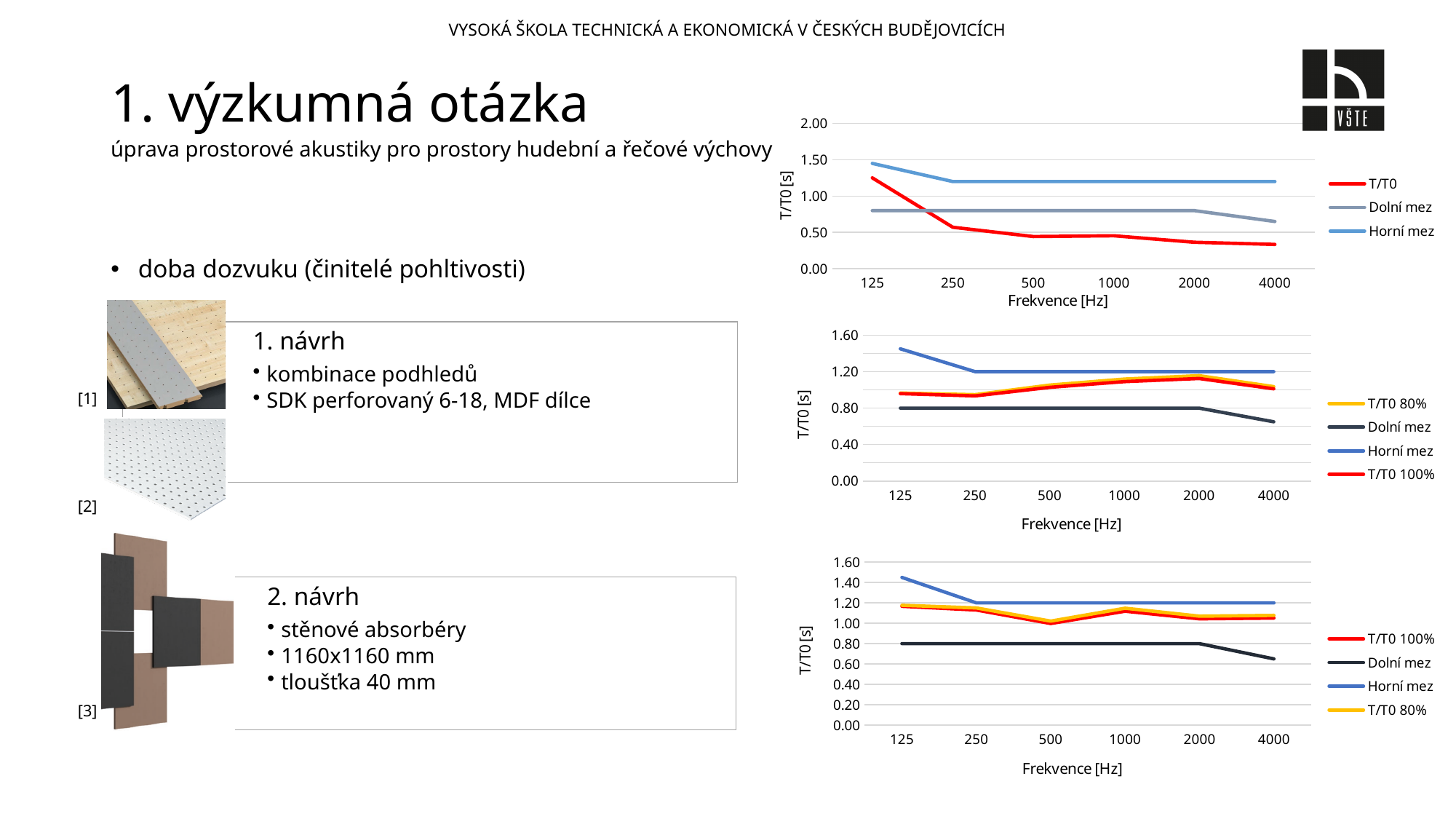
In the bottom chart, what is the value of Horní mez at 2000 Hz? 1.20 How many series does the legend of the top chart list? 3 How many series does the legend of the middle chart list? 4 What is the x-axis label of the middle chart? Frekvence [Hz] What kind of chart is the top chart on the right of the slide? line chart How many frequency points are plotted along the x axis of the bottom chart? 6 In the middle chart, what is the value of Dolní mez at 1000 Hz? 0.80 In the top chart, which series has the highest value at 125 Hz? Horní mez In the top chart, is the value of T/T0 at 125 Hz greater or less than 1.00? greater In the bottom chart, is the value of T/T0 80% at 125 Hz greater or less than 1.00? greater In the top chart, is the value of T/T0 at 4000 Hz greater or less than 0.50? less In the top chart, does the T/T0 series rise or fall as frequency increases from 125 Hz to 4000 Hz? fall